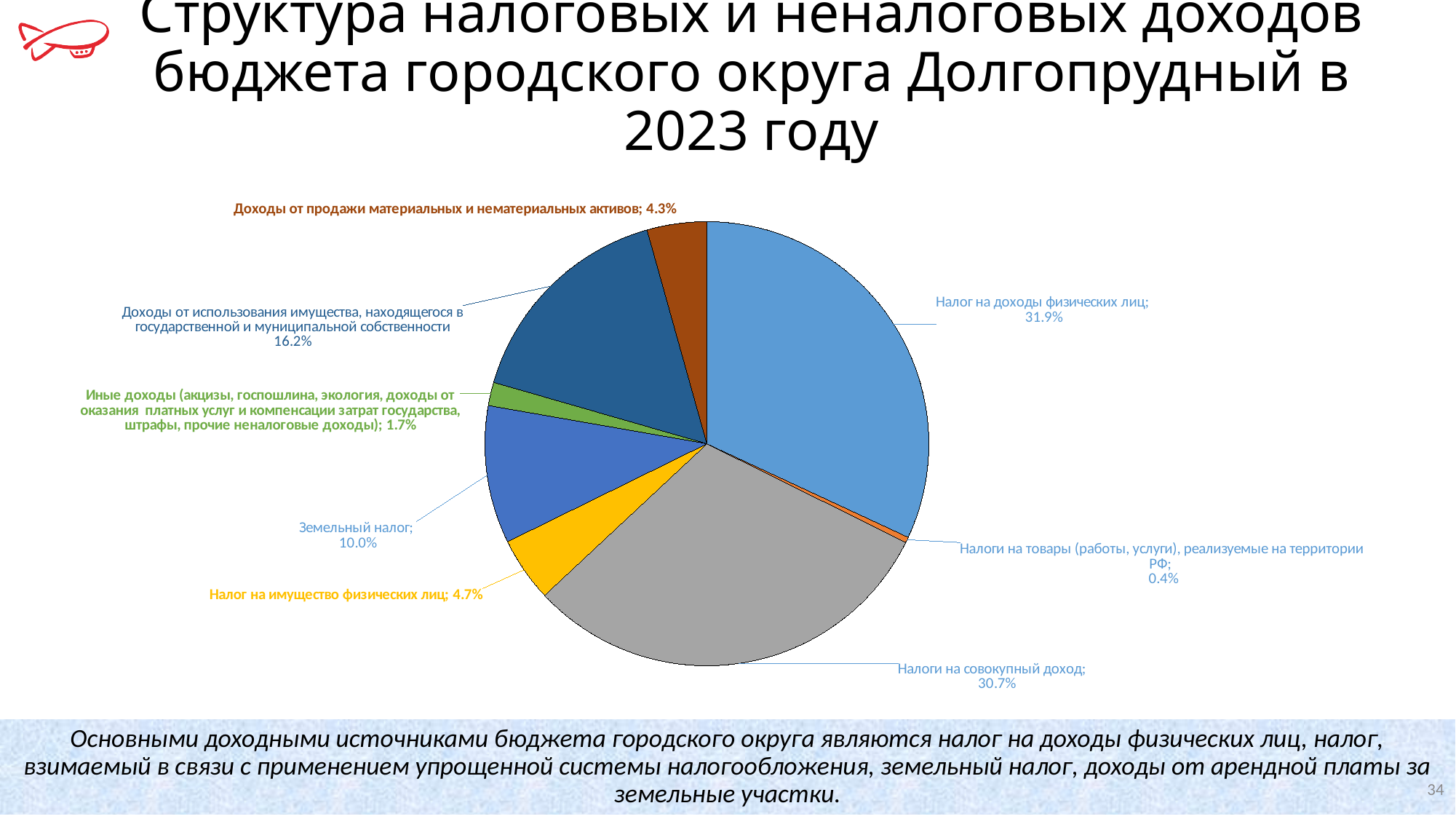
What is the value shown for "Доходы от использования имущества, находящегося в государственной и муниципальной собственности"? 16.2% What share of the pie is "Налоги на совокупный доход"? 30.7% What colour is the slice for "Налоги на совокупный доход"? grey What is the value shown for "Налоги на товары (работы, услуги), реализуемые на территории РФ"? 0.4% Which category has the largest share of the pie? Налог на доходы физических лиц What kind of chart is shown on the slide? pie chart How many slices does the pie chart have? 8 What is the difference between the shares of "Налог на доходы физических лиц" and "Налоги на совокупный доход"? 1.2% Which category has the smallest share of the pie? Налоги на товары (работы, услуги), реализуемые на территории РФ What share of the pie is "Налог на доходы физических лиц"? 31.9% Which is larger: "Налог на имущество физических лиц" or "Доходы от продажи материальных и нематериальных активов"? Налог на имущество физических лиц What is the value shown for "Земельный налог"? 10.0%